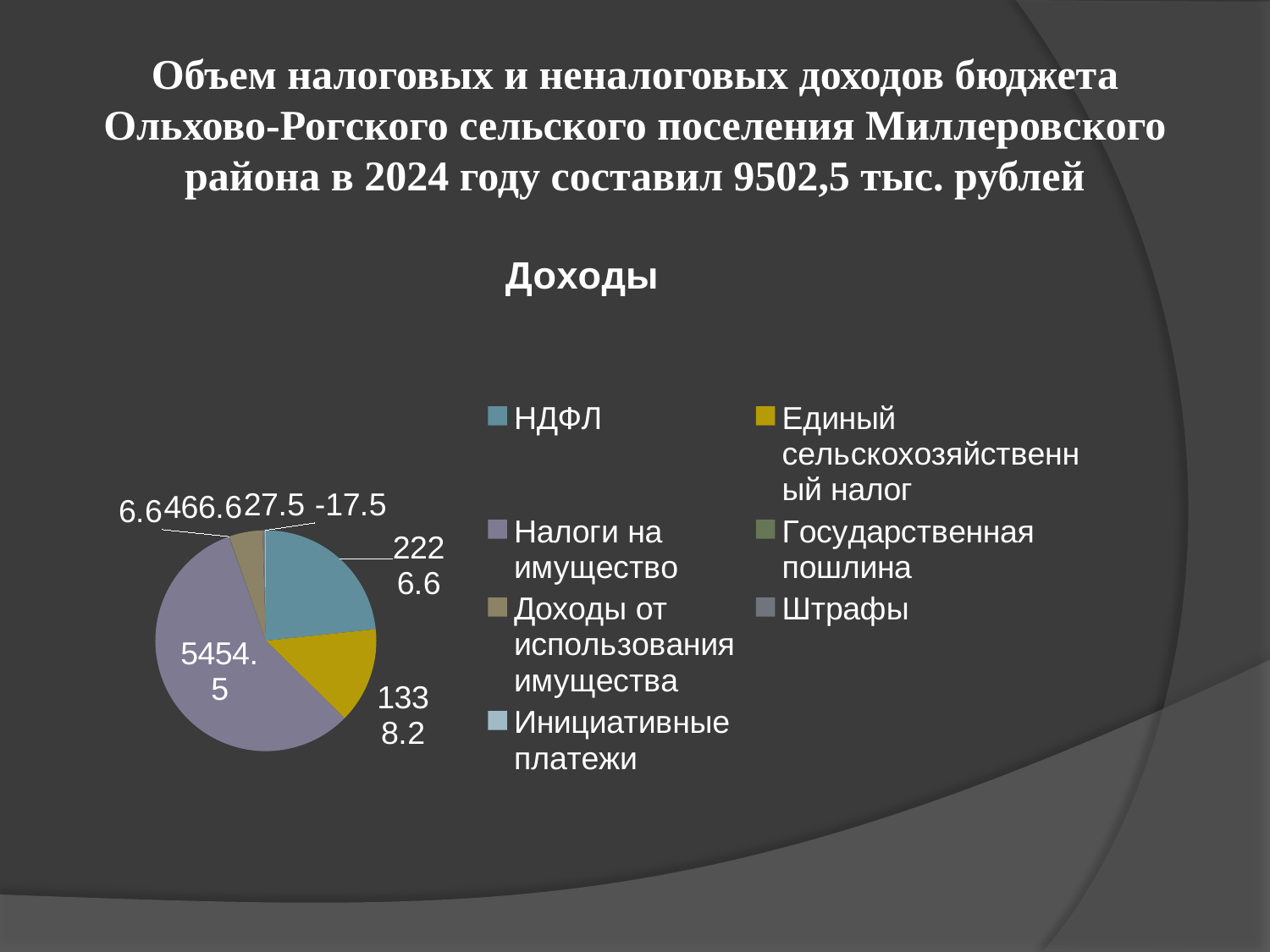
What is the value shown for Налоги на имущество? 5454.5 Which is larger, Налоги на имущество or НДФЛ? Налоги на имущество What is the difference between НДФЛ and Единый сельскохозяйственный налог? 888.4 What is the difference between Налоги на имущество and НДФЛ? 3227.9 Which legend entry is shown in yellow? Единый сельскохозяйственный налог How many entries does the chart legend list? 7 What kind of chart is shown on the slide? pie chart What is the value shown for Единый сельскохозяйственный налог? 1338.2 Which is larger, НДФЛ or Единый сельскохозяйственный налог? НДФЛ What is the value shown for НДФЛ? 2226.6 What is the title of the chart? Доходы Which category has the largest slice of the pie? Налоги на имущество